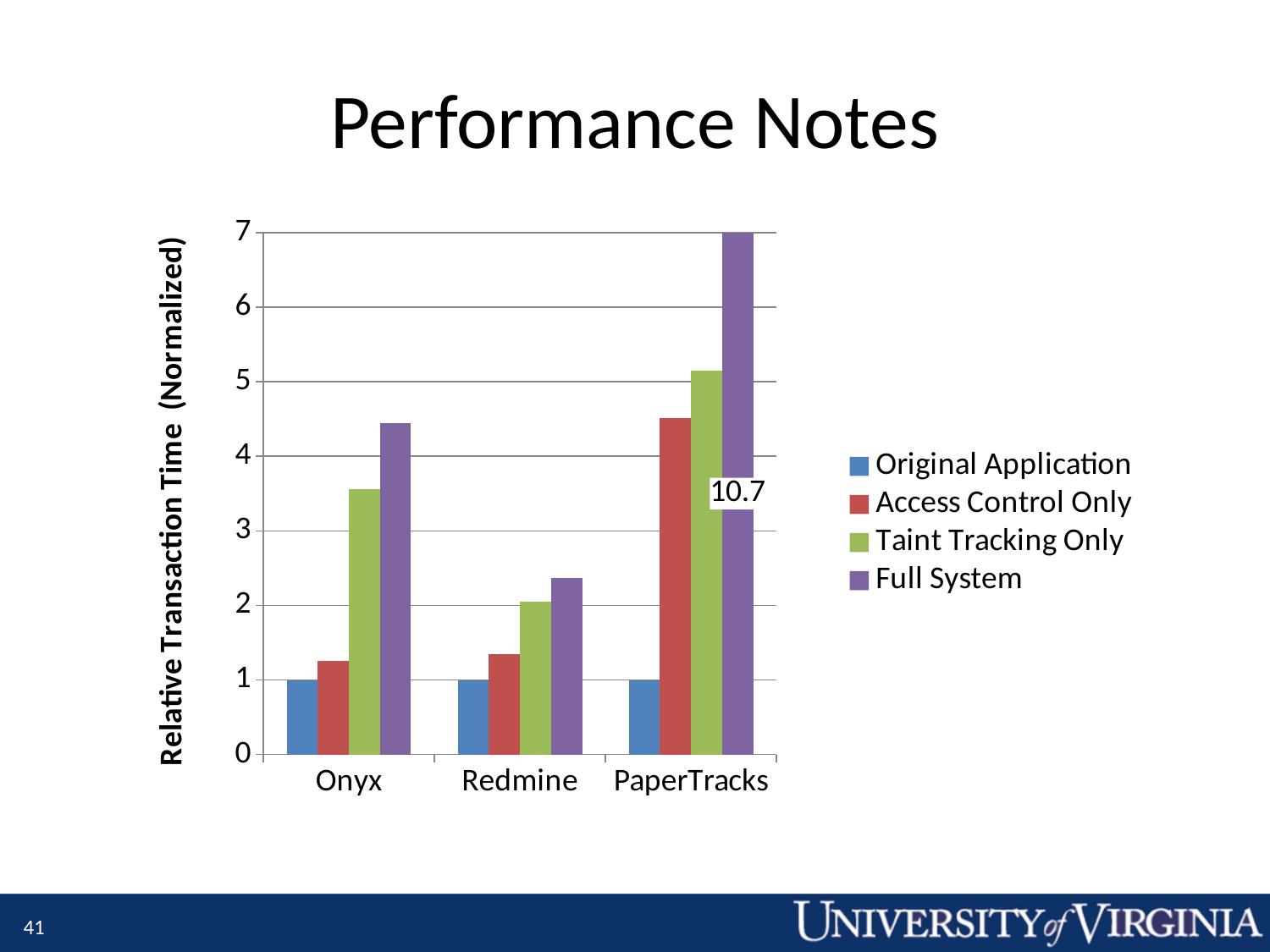
What is the Original Application value for Onyx? 1 Which application has the highest Full System value? PaperTracks What is the difference between the Full System value and the Original Application value for PaperTracks? 9.7 What kind of chart is shown on the slide? bar chart Is the Taint Tracking Only value for Redmine greater or less than 3? less What is the title of the y axis? Relative Transaction Time (Normalized) How many application categories are shown on the x axis? 3 For PaperTracks, which is larger: Access Control Only or Taint Tracking Only? Taint Tracking Only How many series does the legend list? 4 Is the Full System value for Onyx greater or less than 4? greater Is the Access Control Only value for Onyx greater or less than 2? less What is the Full System value for PaperTracks? 10.7